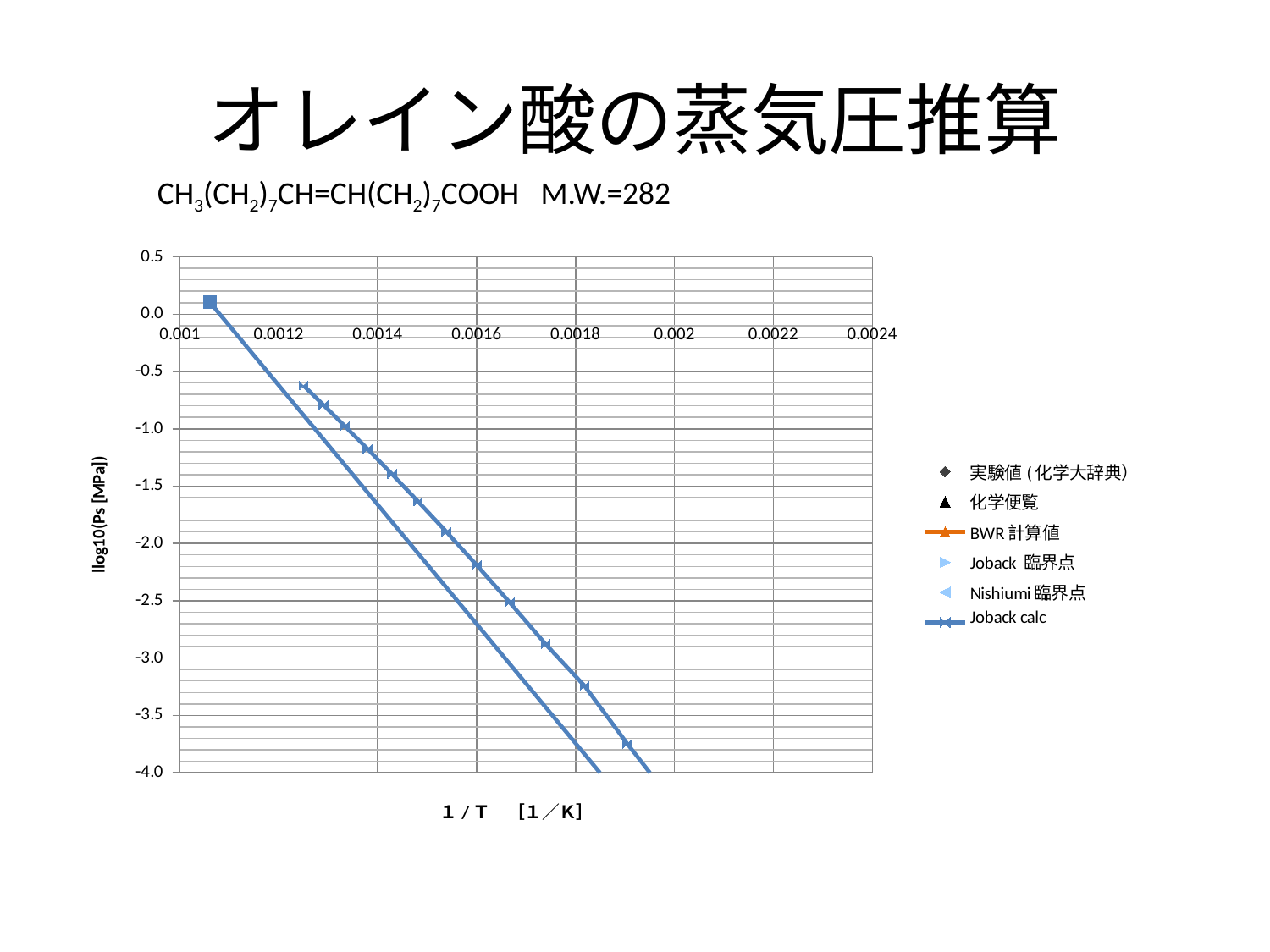
Is the value of the square marker near 1/T = 0.0011 greater or less than -0.5? greater What is the last entry listed in the legend? Joback calc Are the plotted line values at 1/T = 0.0014 greater or less than -0.5? less Do the plotted values rise or fall as 1/T increases along the x axis? fall What kind of chart is shown on the slide? line chart Are the plotted line values at 1/T = 0.002 greater or less than -3.0? less What is the title of the y axis? log10(Ps [MPa]) How many entries does the legend list? 6